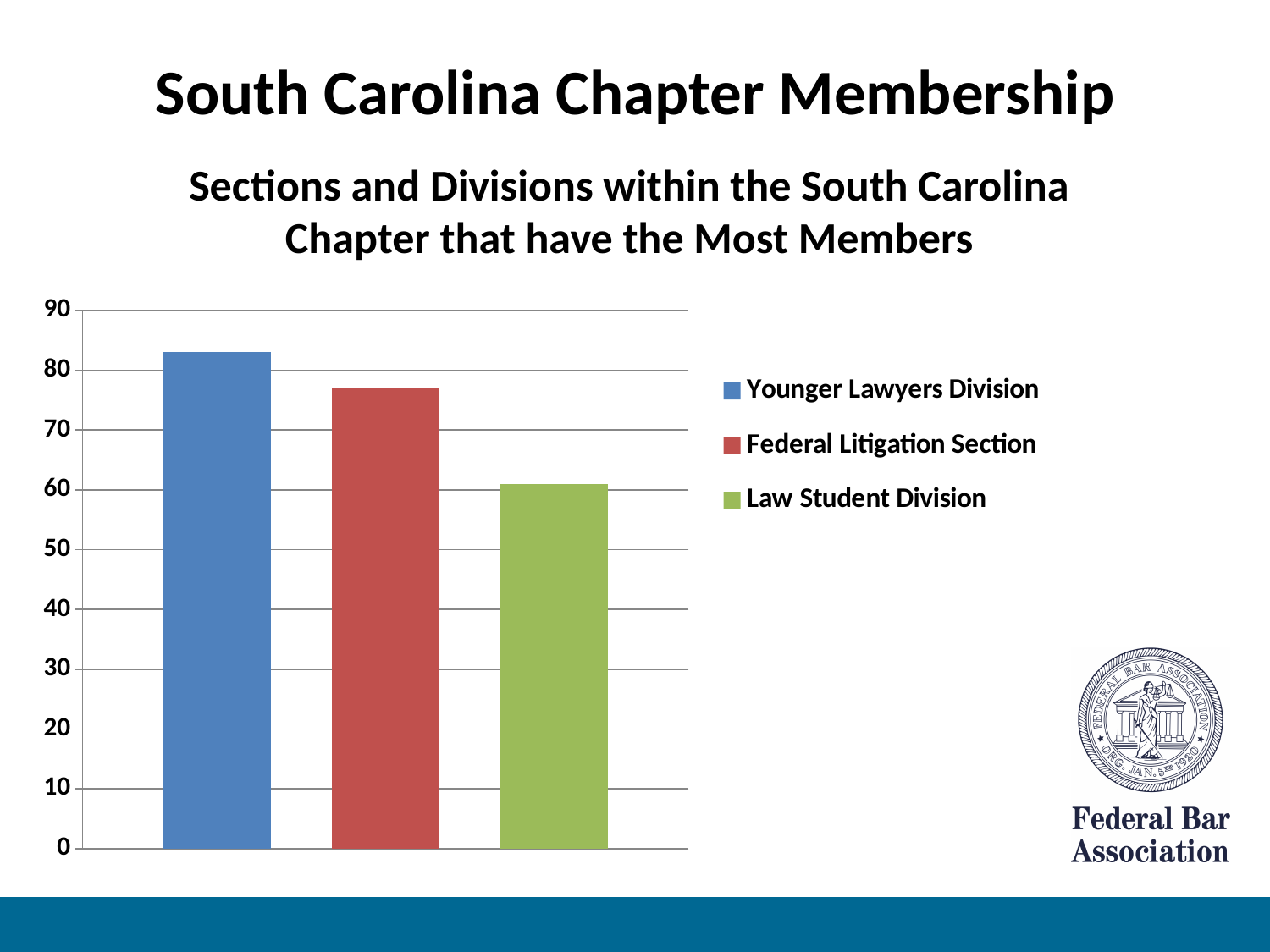
Is the value for the Younger Lawyers Division greater or less than 80? greater Which group has the lowest number of members in the chart? Law Student Division Is the value for the Federal Litigation Section greater or less than 80? less How many entries does the chart legend list? 3 Is the value for the Federal Litigation Section greater or less than 70? greater Which group has the highest number of members in the chart? Younger Lawyers Division What kind of chart is shown on the slide? Bar chart Which has more members, the Younger Lawyers Division or the Federal Litigation Section? Younger Lawyers Division What colour is the bar for the Younger Lawyers Division? Blue Which has more members, the Federal Litigation Section or the Law Student Division? Federal Litigation Section How many bars are plotted in the chart? 3